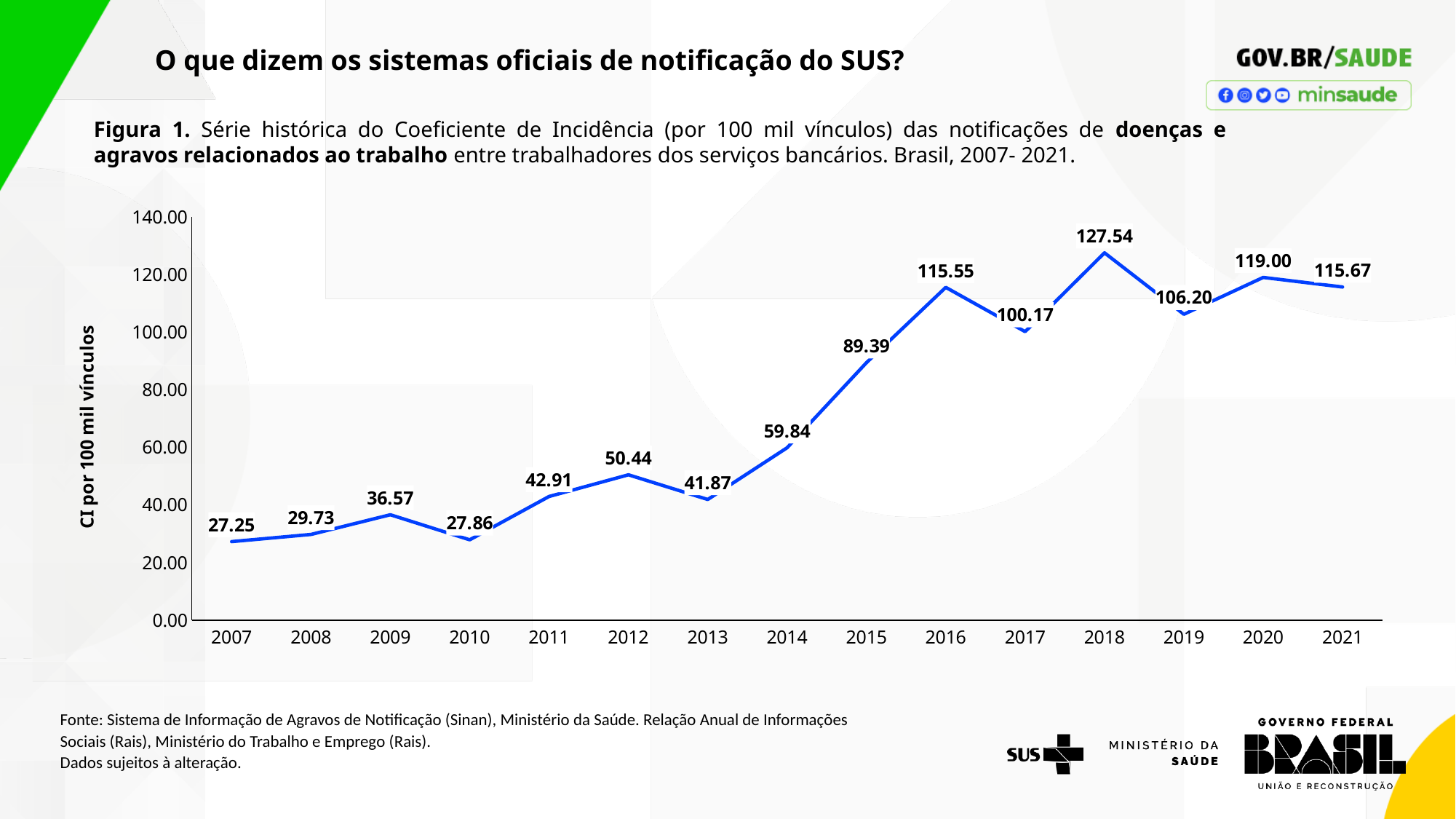
Which is larger, the value for 2020 or the value for 2021? 2020 Is the value for 2016 greater or less than 100.00? greater What is the difference between the values for 2018 and 2017? 27.37 Do the values generally rise or fall from 2007 to 2021? rise What is the value for 2007? 27.25 What kind of chart is shown? line chart Which year has the highest value? 2018 What is the label of the y axis? CI por 100 mil vínculos What is the value for 2018? 127.54 Which year has the lowest value? 2007 How many years are plotted on the x axis? 15 What is the value for 2015? 89.39